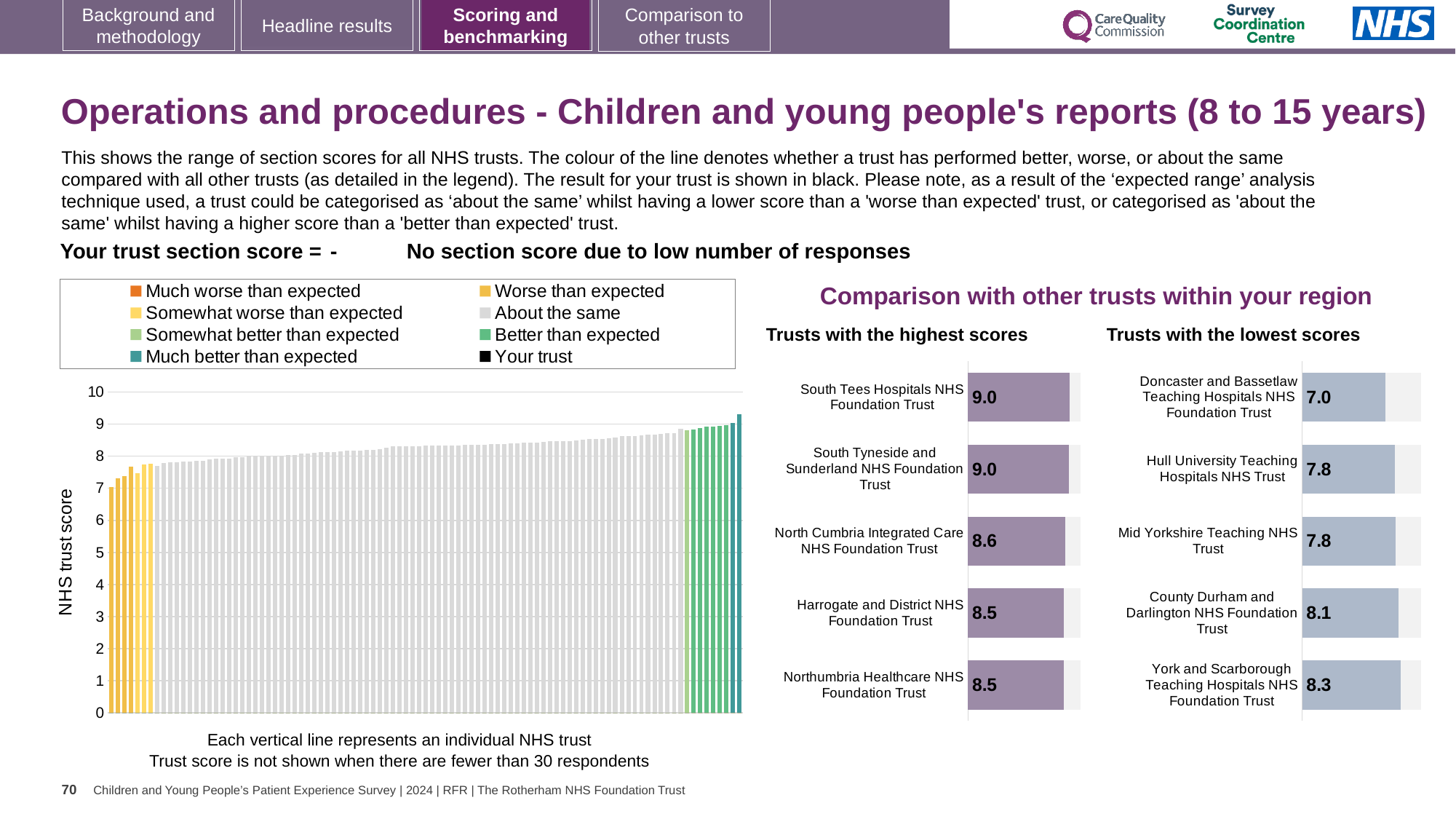
In the 'Trusts with the lowest scores' chart, what is the score for Doncaster and Bassetlaw Teaching Hospitals NHS Foundation Trust? 7.0 What kind of chart is the large 'NHS trust score' chart on the left of the slide? Bar chart In the 'Trusts with the lowest scores' chart, which trust has the highest score? York and Scarborough Teaching Hospitals NHS Foundation Trust In the large 'NHS trust score' chart on the left, is the value of the tallest bar greater or less than 10? less In the 'Trusts with the highest scores' chart, what is the difference between the score for South Tees Hospitals NHS Foundation Trust and the score for Northumbria Healthcare NHS Foundation Trust? 0.5 How many trusts are listed in the 'Trusts with the highest scores' chart? 5 In the 'Trusts with the highest scores' chart, which has the larger score: North Cumbria Integrated Care NHS Foundation Trust or Harrogate and District NHS Foundation Trust? North Cumbria Integrated Care NHS Foundation Trust How many entries does the legend above the large 'NHS trust score' chart list? 8 In the 'Trusts with the lowest scores' chart, which trust has the lowest score? Doncaster and Bassetlaw Teaching Hospitals NHS Foundation Trust In the 'Trusts with the lowest scores' chart, what is the score for County Durham and Darlington NHS Foundation Trust? 8.1 In the 'Trusts with the lowest scores' chart, what is the difference between the score for York and Scarborough Teaching Hospitals NHS Foundation Trust and the score for Doncaster and Bassetlaw Teaching Hospitals NHS Foundation Trust? 1.3 In the 'Trusts with the highest scores' chart, what is the score for North Cumbria Integrated Care NHS Foundation Trust? 8.6